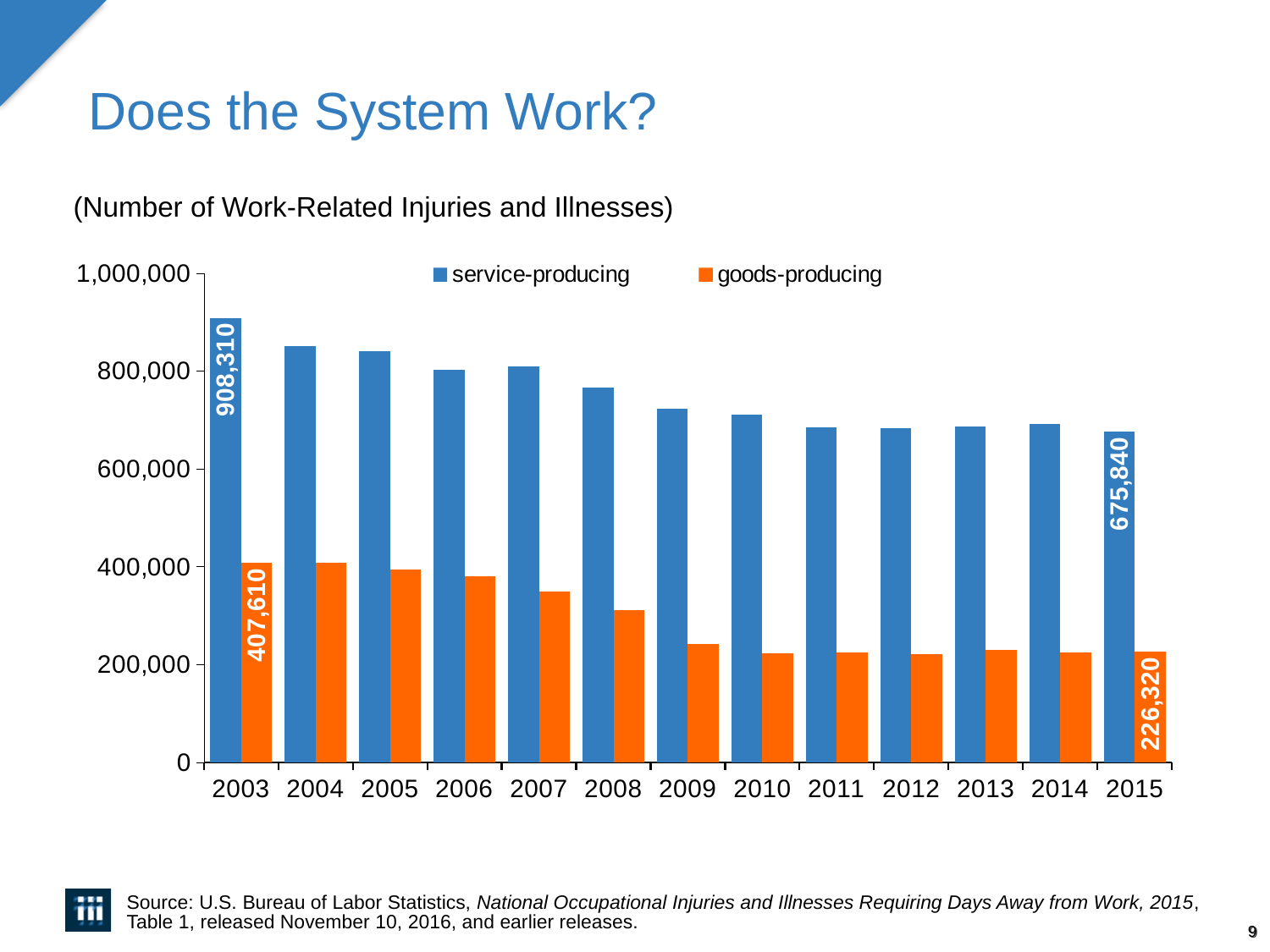
How many series does the legend list? 2 Which year has the highest service-producing value? 2003 What is the value for service-producing in 2003? 908,310 What kind of chart is shown on the slide? bar chart Is the service-producing value for 2008 greater or less than 800,000? less What is the value for goods-producing in 2003? 407,610 What is the difference between the goods-producing values in 2003 and 2015? 181,290 Is the goods-producing value for 2009 greater or less than 200,000? greater What is the value for service-producing in 2015? 675,840 What is the value for goods-producing in 2015? 226,320 What is the difference between the service-producing values in 2003 and 2015? 232,470 How many years are shown on the x axis? 13